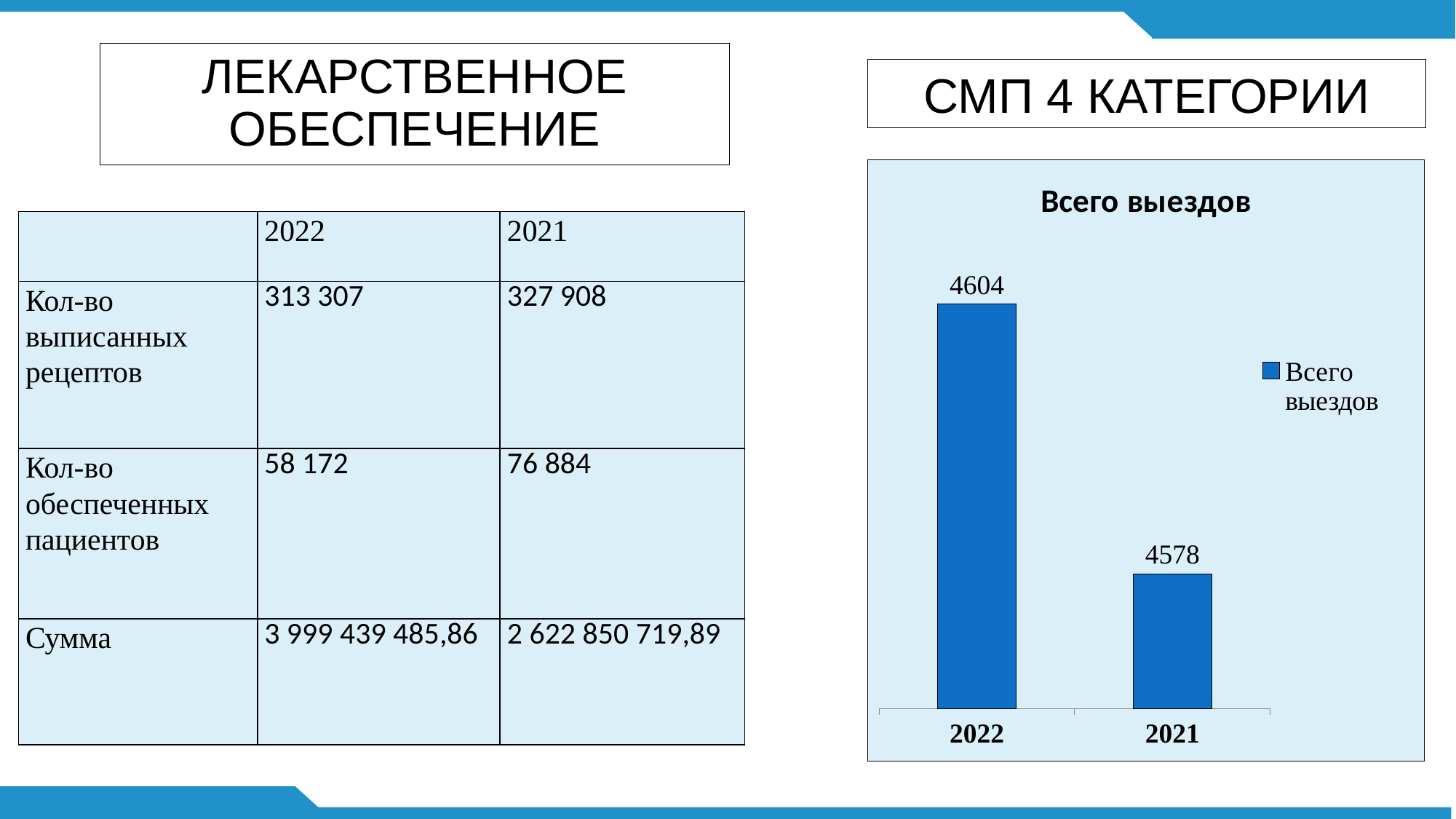
Which year has the lowest value in the "Всего выездов" chart? 2021 Do the values in the "Всего выездов" chart rise or fall from left to right along the x axis? fall What kind of chart is the "Всего выездов" chart? bar chart How many series does the legend of the "Всего выездов" chart list? 1 What series name is shown in the legend of the "Всего выездов" chart? Всего выездов What is the value for 2021 in the "Всего выездов" chart? 4578 What is the value for 2022 in the "Всего выездов" chart? 4604 Which year has the highest value in the "Всего выездов" chart? 2022 In the "Всего выездов" chart, is the value for 2022 or 2021 larger? 2022 What is the title of the chart on the right side of the slide? Всего выездов What is the difference between the 2022 and 2021 values in the "Всего выездов" chart? 26 How many bars are shown in the "Всего выездов" chart? 2